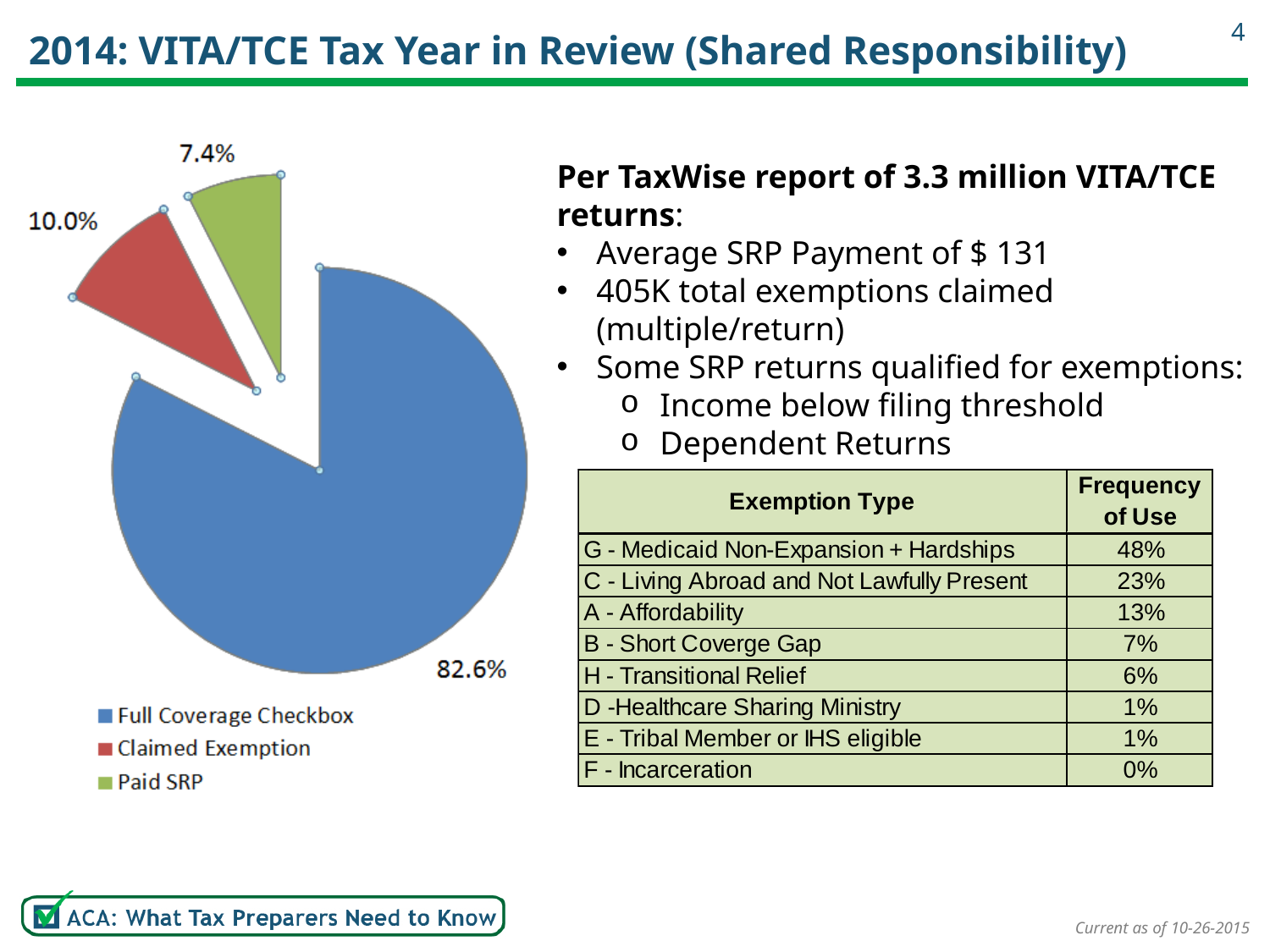
What share of the pie is Claimed Exemption? 10.0% What share of the pie is Paid SRP? 7.4% What share of the pie is Full Coverage Checkbox? 82.6% Which slice of the pie chart is the largest? Full Coverage Checkbox Which slice of the pie chart is the smallest? Paid SRP What colour is the Claimed Exemption slice in the pie chart? red Which is larger in the pie chart, Claimed Exemption or Paid SRP? Claimed Exemption What is the difference between the Claimed Exemption share and the Paid SRP share? 2.6% How many entries does the pie chart's legend list? 3 What kind of chart is shown on the slide? pie chart How many slices does the pie chart have? 3 What colour is the Full Coverage Checkbox slice in the pie chart? blue